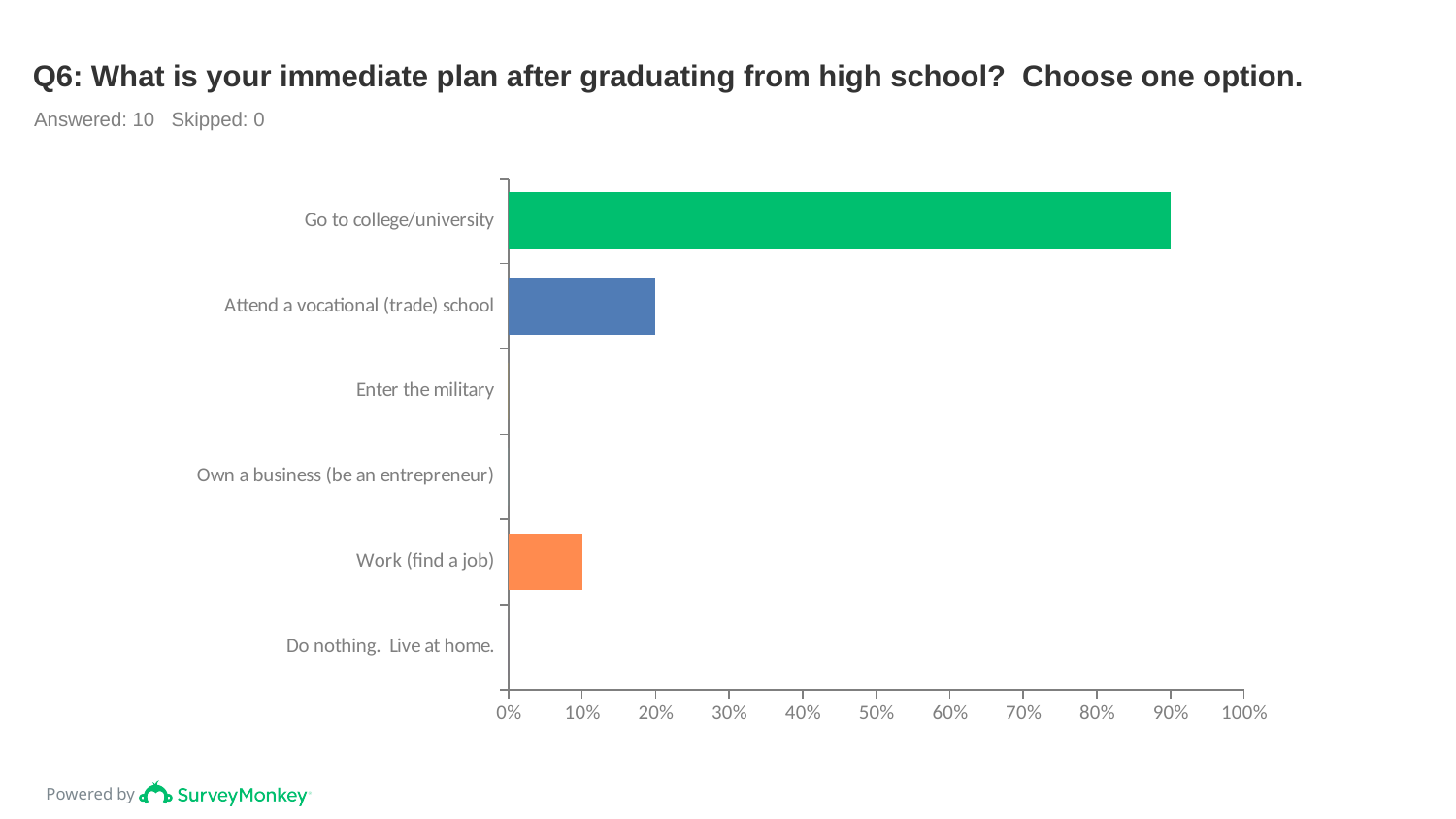
What is the difference between the values for Attend a vocational (trade) school and Work (find a job)? 10% Which is larger, the value for Attend a vocational (trade) school or the value for Work (find a job)? Attend a vocational (trade) school What kind of chart is shown on the slide? bar chart What is the title of the chart? Q6: What is your immediate plan after graduating from high school? Choose one option. What is the value for Attend a vocational (trade) school? 20% Which category has the highest value? Go to college/university Is the value for Go to college/university greater or less than 50%? greater What is the value for Go to college/university? 90% What is the difference between the values for Go to college/university and Attend a vocational (trade) school? 70% How many categories have no visible bar on the chart? 3 How many categories are shown on the chart? 6 What is the value for Work (find a job)? 10%